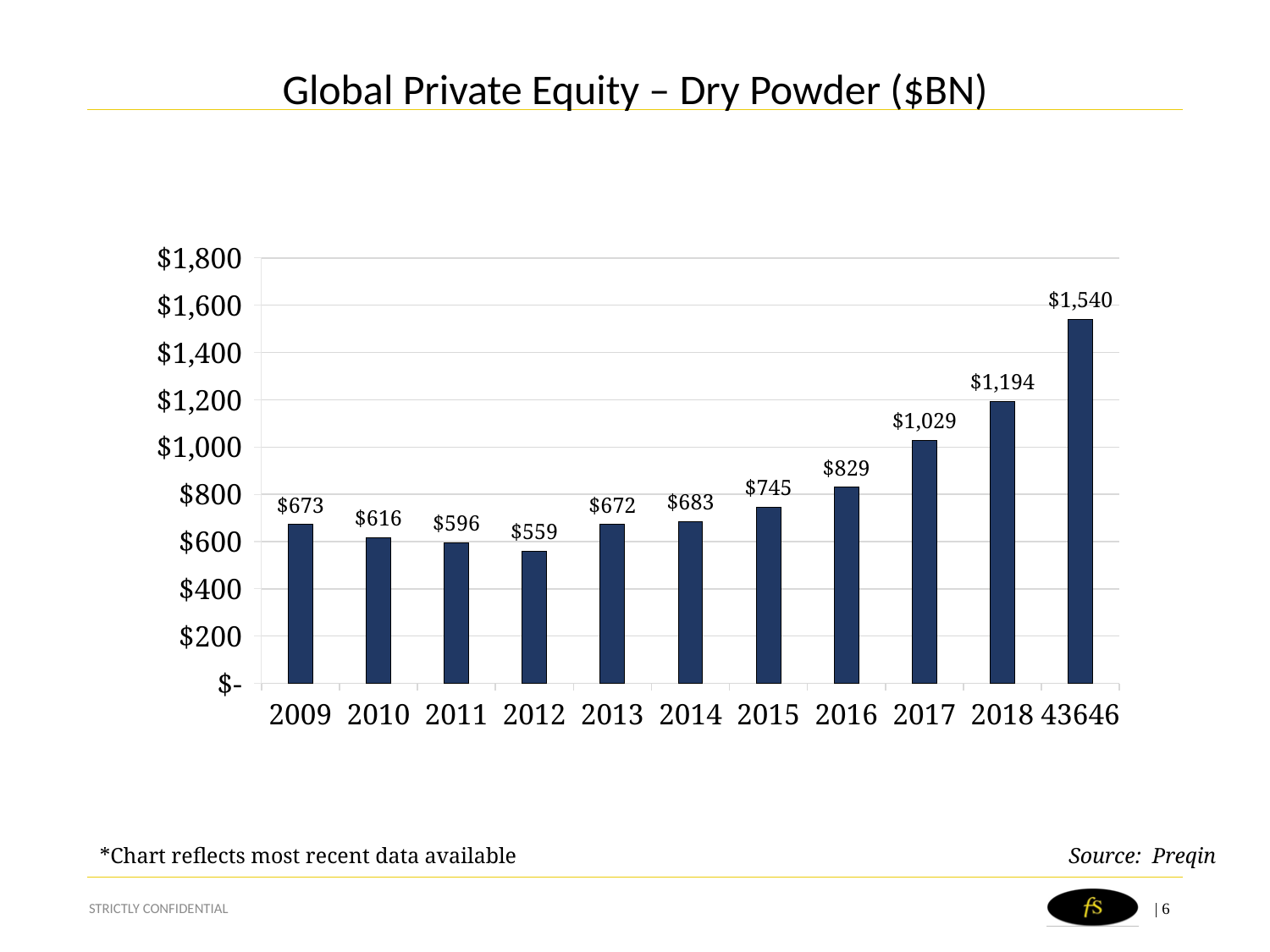
What is the dry powder value for 2012? $559 How many bars are shown in the chart? 11 Is the value for 2016 greater or less than $800? greater What is the title of the chart? Global Private Equity – Dry Powder ($BN) Which year has the lowest dry powder value? 2012 What is the dry powder value for 2017? $1,029 What kind of chart is shown on the slide? Bar chart What is the difference between the 2018 value and the 2017 value? $165 Which category has the highest dry powder value? 43646 What is the value shown for the category labelled 43646? $1,540 Do the values generally rise or fall from 2012 to 43646? Rise Which is larger, the value for 2009 or the value for 2013? 2009